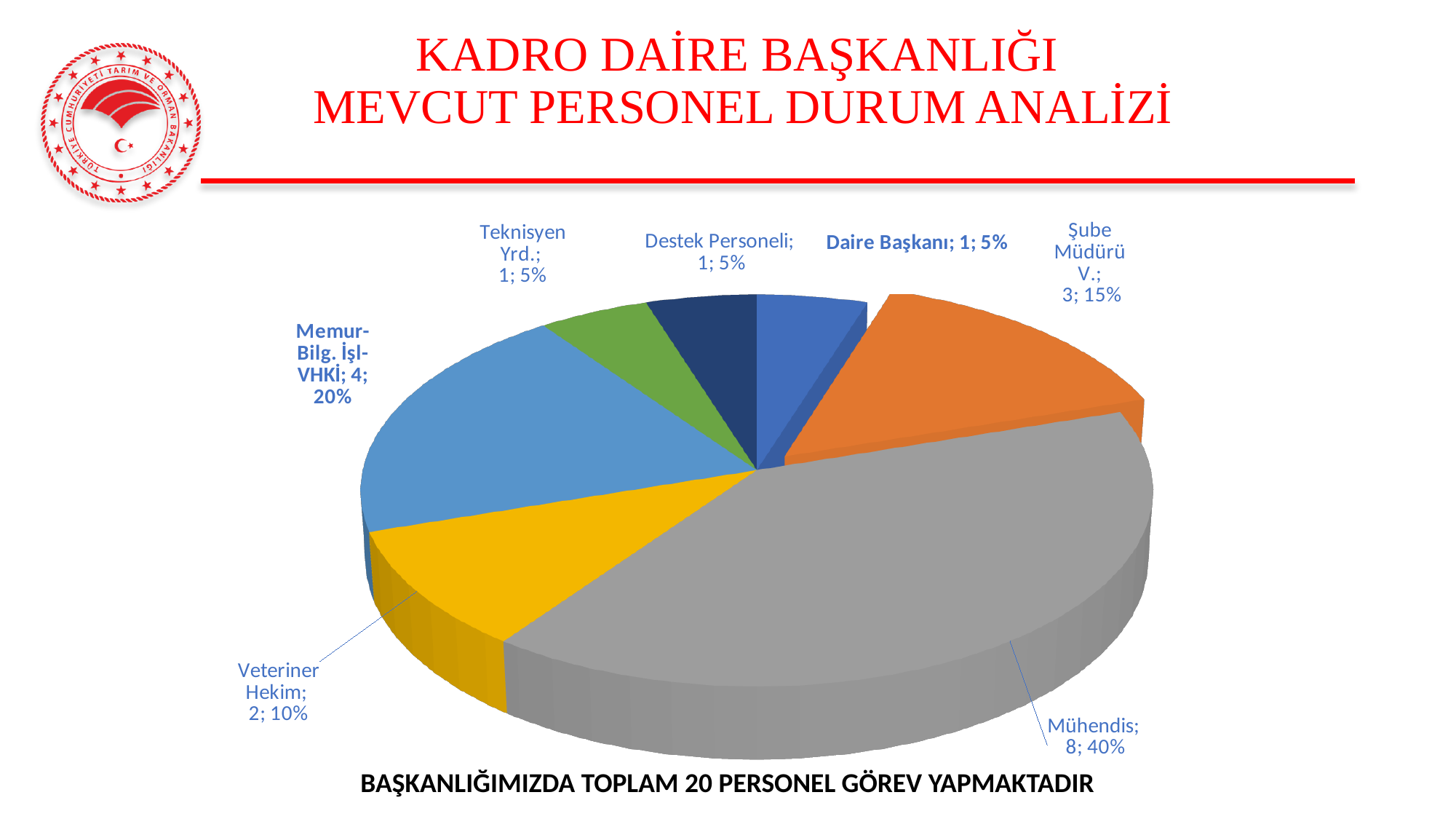
Which category has the largest slice of the pie? Mühendis What is the difference in personnel count between Mühendis and Memur-Bilg. İşl-VHKİ? 4 What is the total number of personnel across all slices of the pie chart? 20 What share of the pie does Mühendis represent? 40% What share of the pie does Veteriner Hekim represent? 10% What is the title shown at the top of the slide? KADRO DAİRE BAŞKANLIĞI MEVCUT PERSONEL DURUM ANALİZİ What share of the pie does Memur-Bilg. İşl-VHKİ represent? 20% How many personnel are in the Şube Müdürü V. category? 3 Which is larger, the Veteriner Hekim slice or the Şube Müdürü V. slice? Şube Müdürü V. What kind of chart is shown on the slide? Pie chart How many personnel are in the Mühendis category? 8 How many slices does the pie chart have? 7